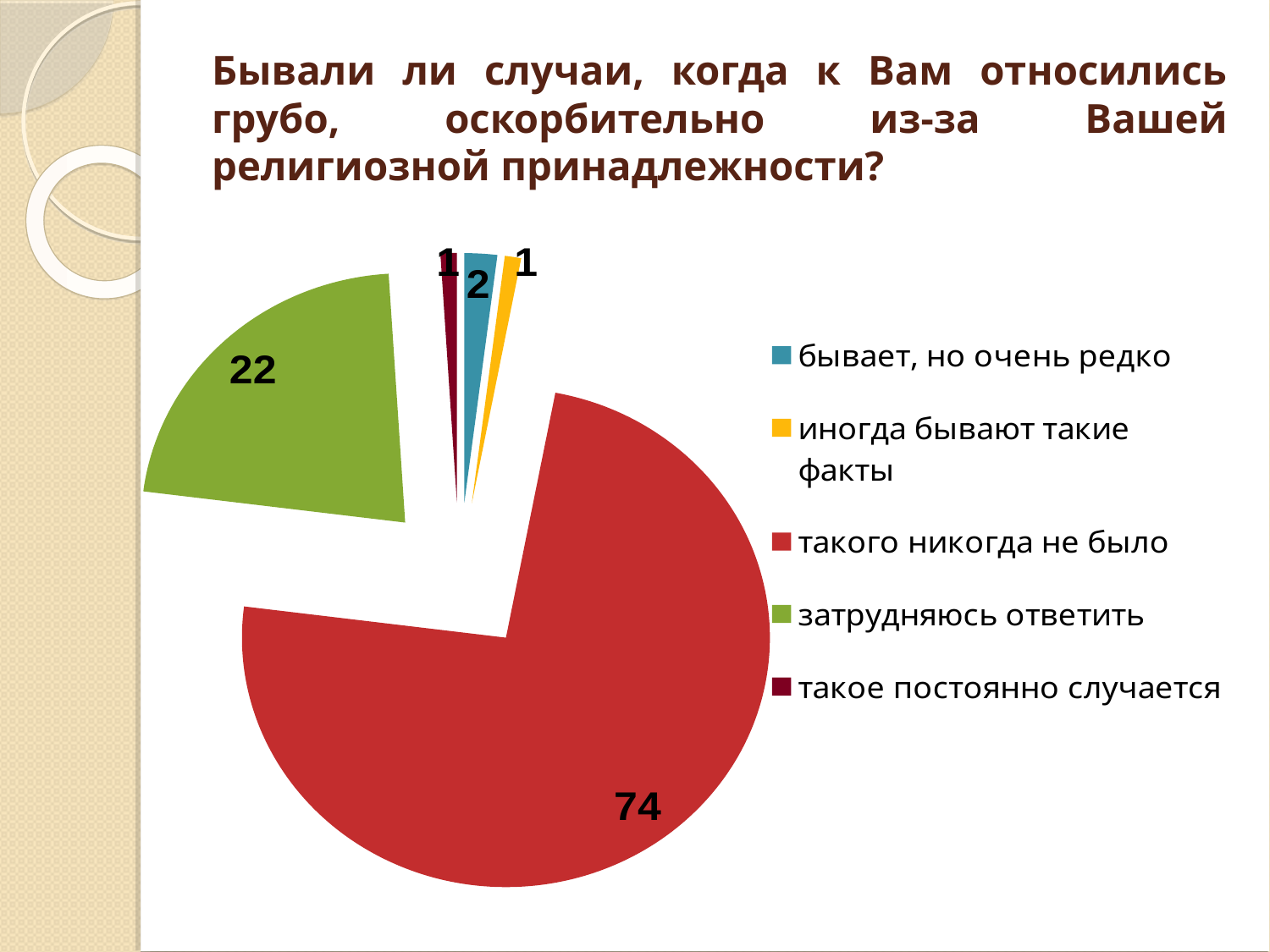
What is the difference between the values for "такого никогда не было" and "затрудняюсь ответить"? 52 How many categories does the legend list? 5 What colour is the slice for "затрудняюсь ответить"? green What is the value for "бывает, но очень редко"? 2 What share of the pie does "такого никогда не было" represent? 74% Which is larger: the value for "затрудняюсь ответить" or the value for "бывает, но очень редко"? затрудняюсь ответить What is the value for "затрудняюсь ответить"? 22 What is the value for "такого никогда не было"? 74 What is the total of all the slice values shown on the chart? 100 Which category has the largest slice of the pie? такого никогда не было What is the value for "иногда бывают такие факты"? 1 What kind of chart is shown on the slide? pie chart